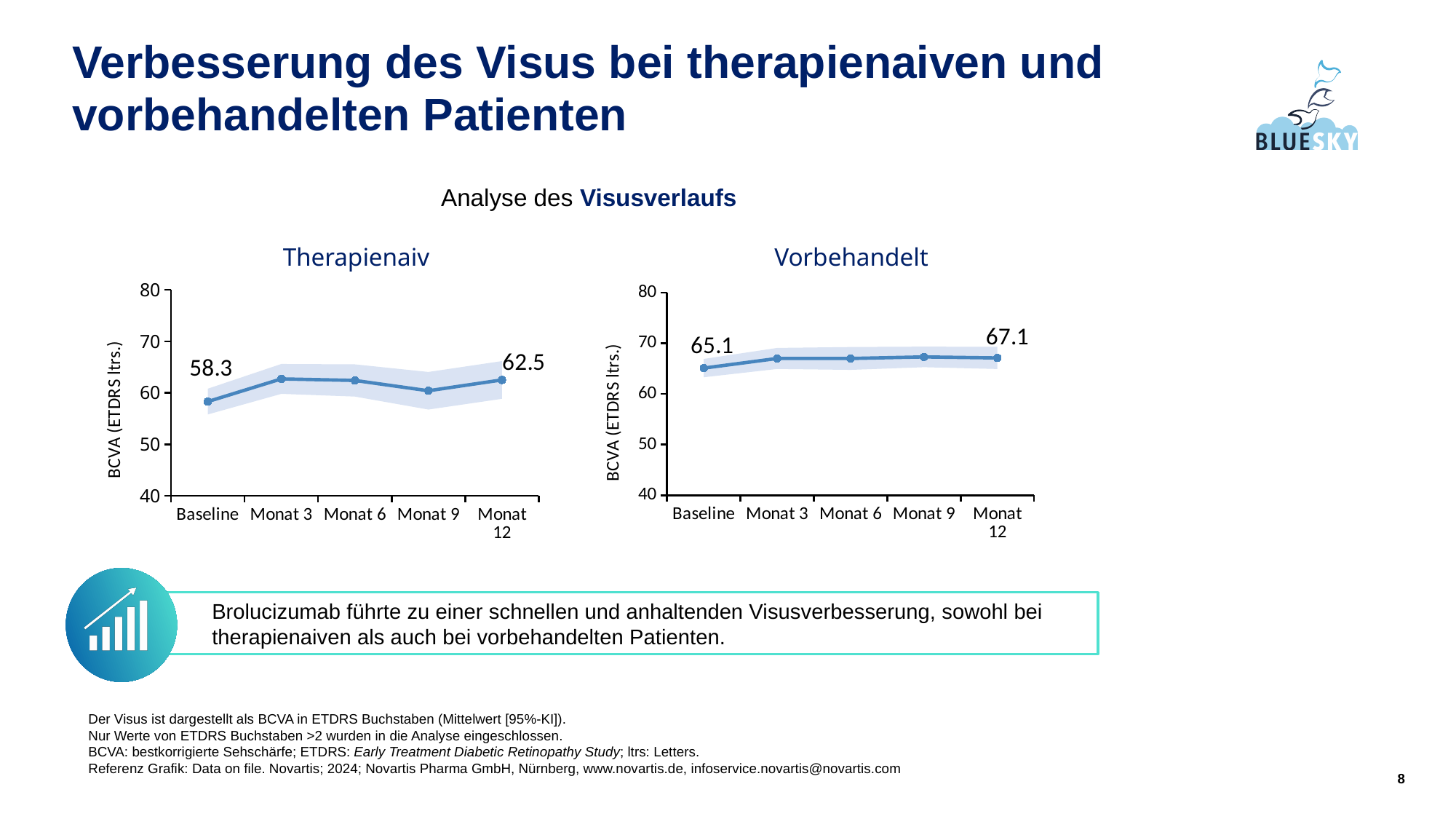
In the Therapienaiv chart, what is the BCVA value at Baseline? 58.3 How many time points are plotted on the x axis of the Therapienaiv chart? 5 In the Therapienaiv chart, what is the difference between the Monat 12 value and the Baseline value? 4.2 In the Therapienaiv chart, is the value at Monat 3 greater or less than 60? greater Which chart has the higher Baseline value, Therapienaiv or Vorbehandelt? Vorbehandelt What kind of chart is the Vorbehandelt chart? Line chart What is the y-axis label of the Therapienaiv chart? BCVA (ETDRS ltrs.) In the Vorbehandelt chart, is the value at Monat 6 greater or less than 70? less In the Vorbehandelt chart, what is the BCVA value at Baseline? 65.1 In the Therapienaiv chart, what is the BCVA value at Monat 12? 62.5 In the Vorbehandelt chart, what is the BCVA value at Monat 12? 67.1 In the Vorbehandelt chart, what is the difference between the Monat 12 value and the Baseline value? 2.0